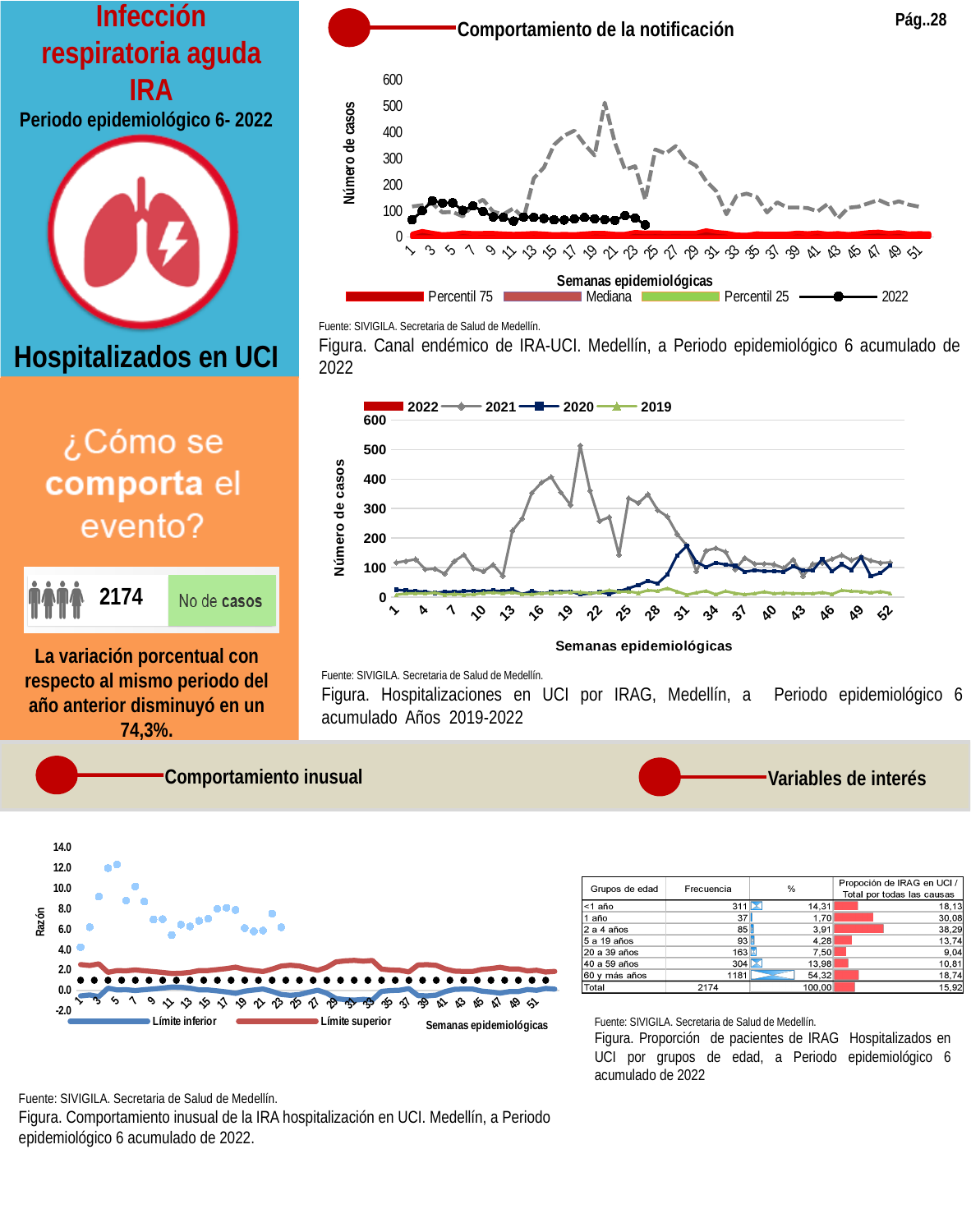
In the table 'Proporción de pacientes de IRAG Hospitalizados en UCI por grupos de edad', what is the difference in Frecuencia between '60 y más años' and '<1 año'? 870 In the 'Hospitalizaciones en UCI por IRAG' chart, is the value of the 2020 series at week 31 greater or less than 200? less In the chart titled 'Hospitalizaciones en UCI por IRAG', which years are listed in the legend? 2022, 2021, 2020, 2019 In the table 'Proporción de pacientes de IRAG Hospitalizados en UCI por grupos de edad', what is the Total Frecuencia? 2174 In the 'Canal endémico de IRA-UCI' chart, what is the label of the y axis? Número de casos In the 'Comportamiento inusual' chart at the bottom left, how many series does the legend list? 2 In the 'Hospitalizaciones en UCI por IRAG' chart, is the peak value of the 2021 series greater or less than 400? greater In the 'Hospitalizaciones en UCI por IRAG' chart, which series reaches the highest value across the year? 2021 What kind of chart is the 'Canal endémico de IRA-UCI' chart? line chart In the table 'Proporción de pacientes de IRAG Hospitalizados en UCI por grupos de edad', what is the Frecuencia for '60 y más años'? 1181 In the table 'Proporción de pacientes de IRAG Hospitalizados en UCI por grupos de edad', which age group has the lowest Frecuencia? 1 año In the chart titled 'Canal endémico de IRA-UCI', how many series does the legend list? 4